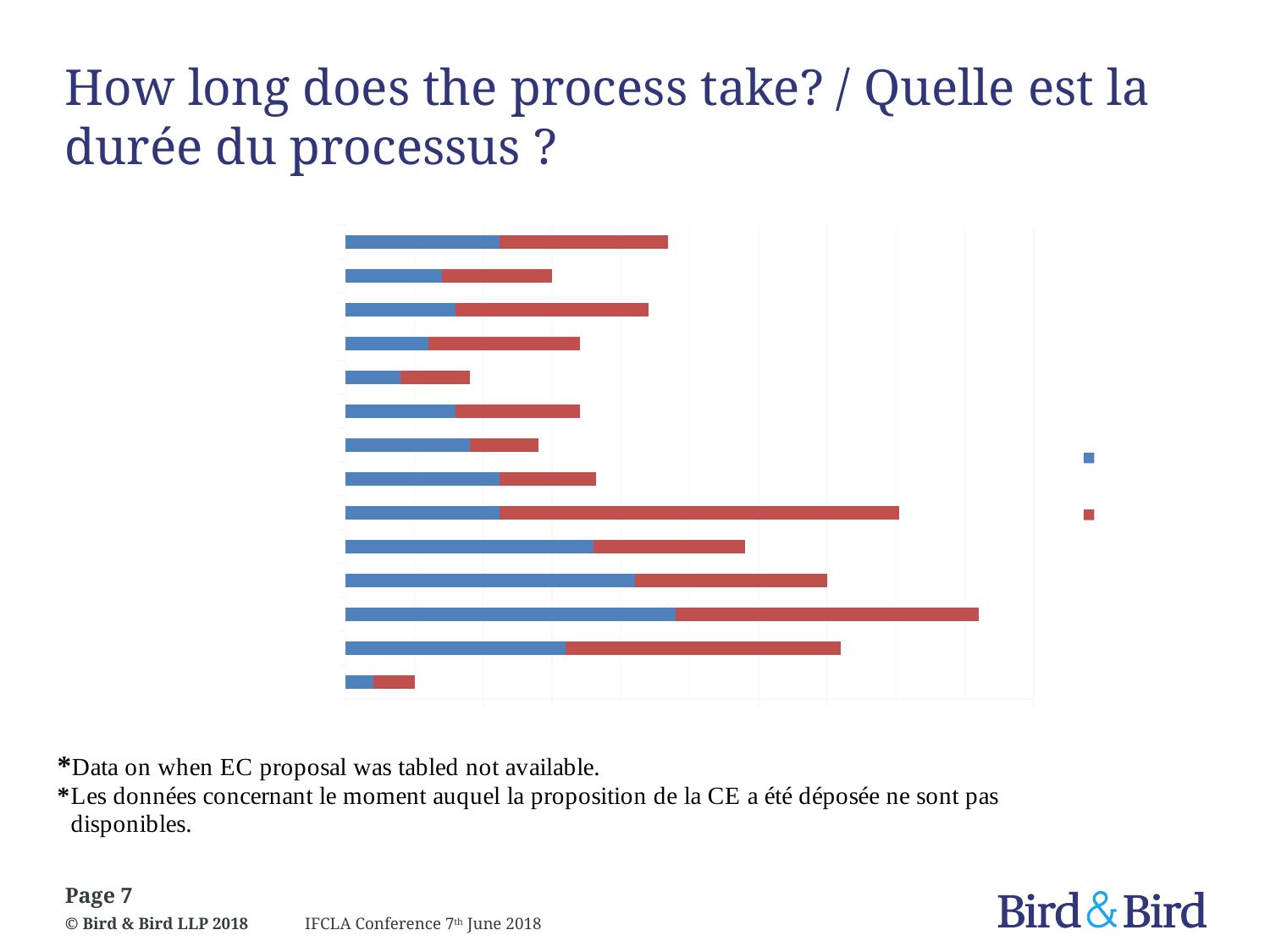
What kind of chart is shown on the slide? bar chart What two colours are used for the segments of the bars? blue and red How many bars does the chart contain? 14 Counting from the top, which bar is the longest overall? the 12th bar Which segment comes first (on the left) in each bar, the blue one or the red one? the blue one Are the bars in the chart horizontal or vertical? horizontal How many series does the chart's legend list? 2 Counting from the top, which bar is the shortest overall? the 14th (bottom) bar